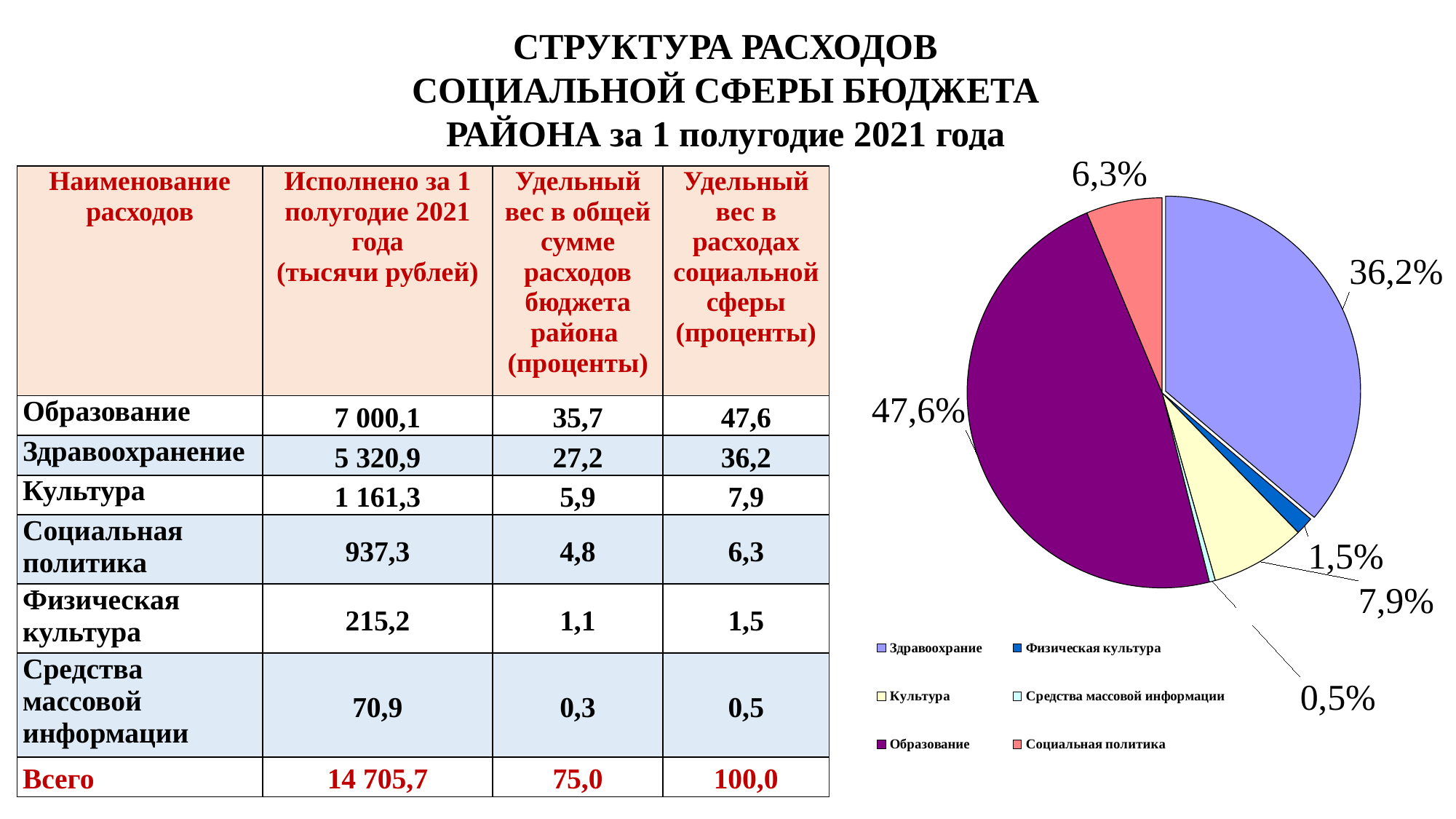
In the pie chart, what share does Культура have? 7,9% In the pie chart, what share does Средства массовой информации have? 0,5% In the pie chart, which is larger: the share of Культура or the share of Социальная политика? Культура In the pie chart, what share does Здравоохранение have? 36,2% In the pie chart, what share does Социальная политика have? 6,3% In the pie chart, what colour is the slice for Физическая культура? blue What kind of chart is shown on the slide? pie chart How many categories does the pie chart's legend list? 6 Which category has the largest slice in the pie chart? Образование In the pie chart, what share does Образование have? 47,6% In the pie chart, what is the difference between the shares of Образование and Здравоохранение? 11,4% Which category has the smallest slice in the pie chart? Средства массовой информации